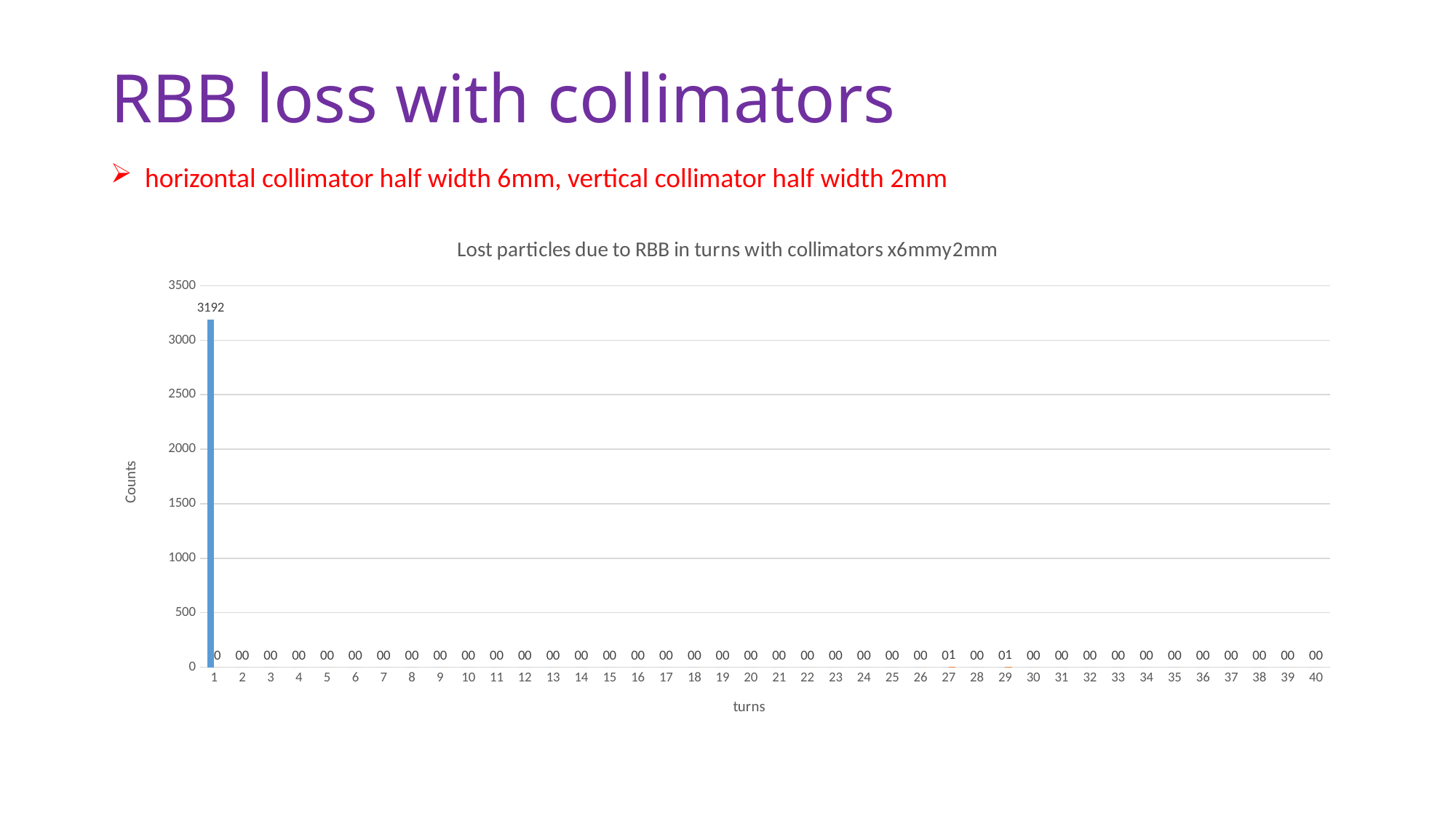
Is the value at turn 1 greater or less than 3500? less What is the highest value shown on the y axis? 3500 What kind of chart is shown on the slide? bar chart How many turns are shown on the x axis? 40 Which is larger, the count at turn 1 or the count at turn 20? turn 1 What is the label of the y axis? Counts Is the value at turn 1 greater or less than 3000? greater Which turn has the highest count? 1 What is the title of the chart? Lost particles due to RBB in turns with collimators x6mmy2mm What is the value of the blue bar at turn 1? 3192 Do the counts rise or fall from turn 1 to turn 2? fall